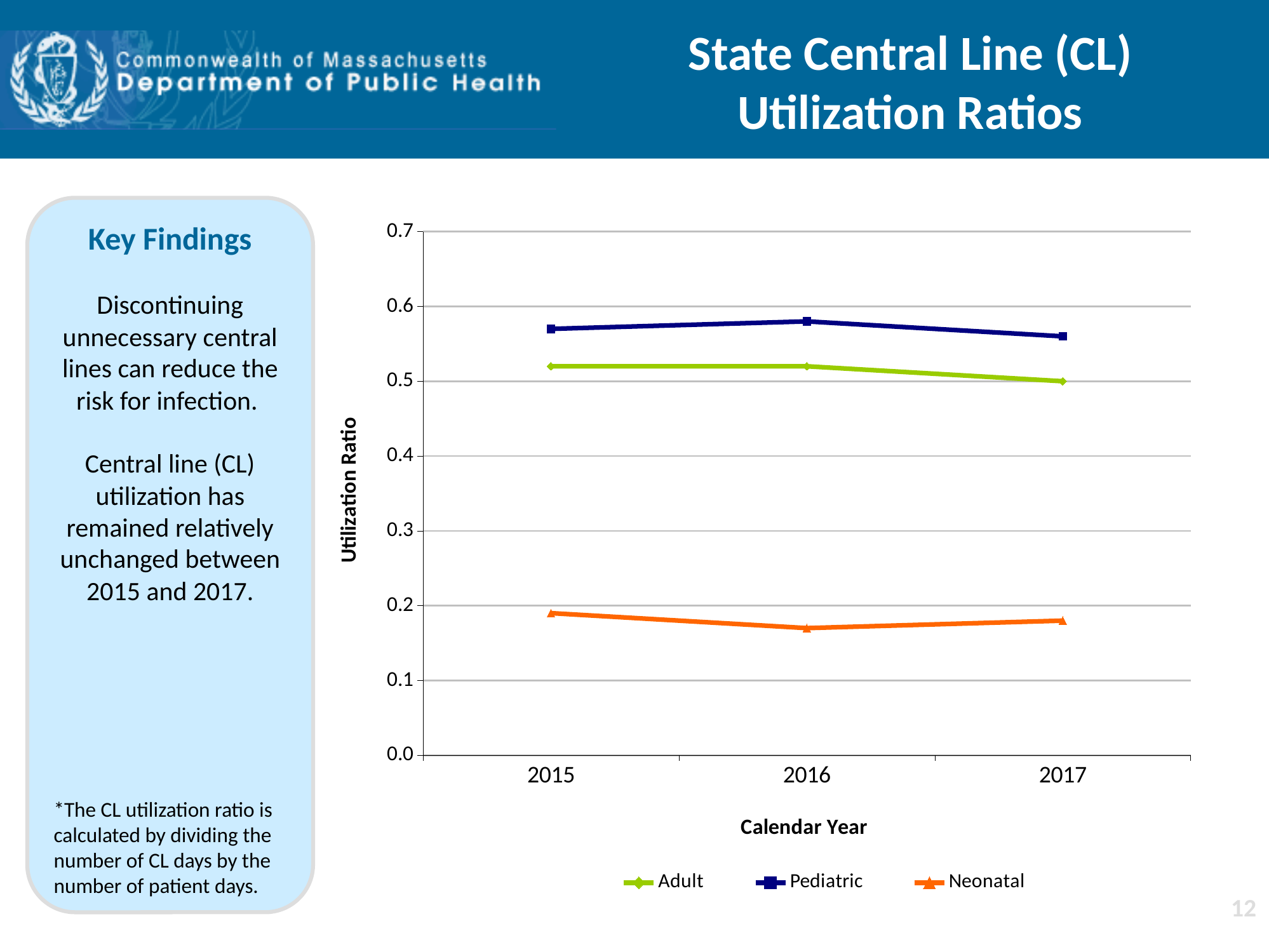
What kind of chart is shown on the slide? line chart How many series does the legend list? 3 What is the title of the x axis? Calendar Year How many calendar years are plotted on the x axis? 3 Does the Adult utilization ratio rise or fall from 2016 to 2017? fall Is the Adult utilization ratio in 2015 greater or less than 0.6? less Which series has the lowest utilization ratio in 2017? Neonatal Which series has the highest utilization ratio in 2015? Pediatric Is the Pediatric utilization ratio in 2016 greater or less than 0.5? greater Is the Neonatal utilization ratio in 2015 greater or less than 0.2? less In 2017, which is larger: the Neonatal or the Adult utilization ratio? Adult In 2016, which is larger: the Pediatric or the Adult utilization ratio? Pediatric